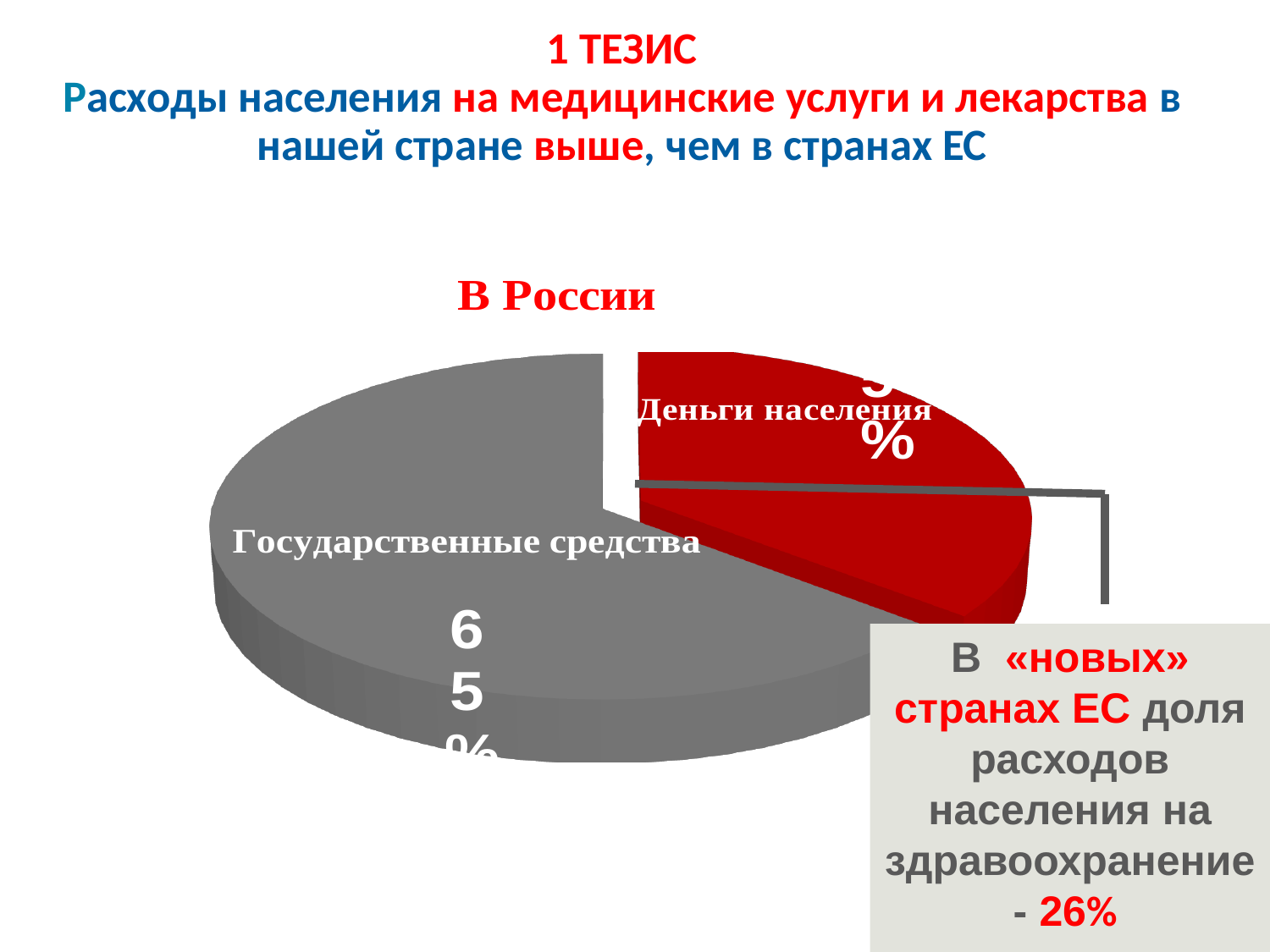
Which is larger in the pie chart, Государственные средства or Деньги населения? Государственные средства Which slice of the pie chart is the largest? Государственные средства Which slice of the pie chart is the smallest? Деньги населения What colour is the Деньги населения slice? red How many slices does the pie chart have? 2 What is the title of the pie chart? В России What share of the pie does Государственные средства take? 65% What kind of chart is shown on the slide? pie chart